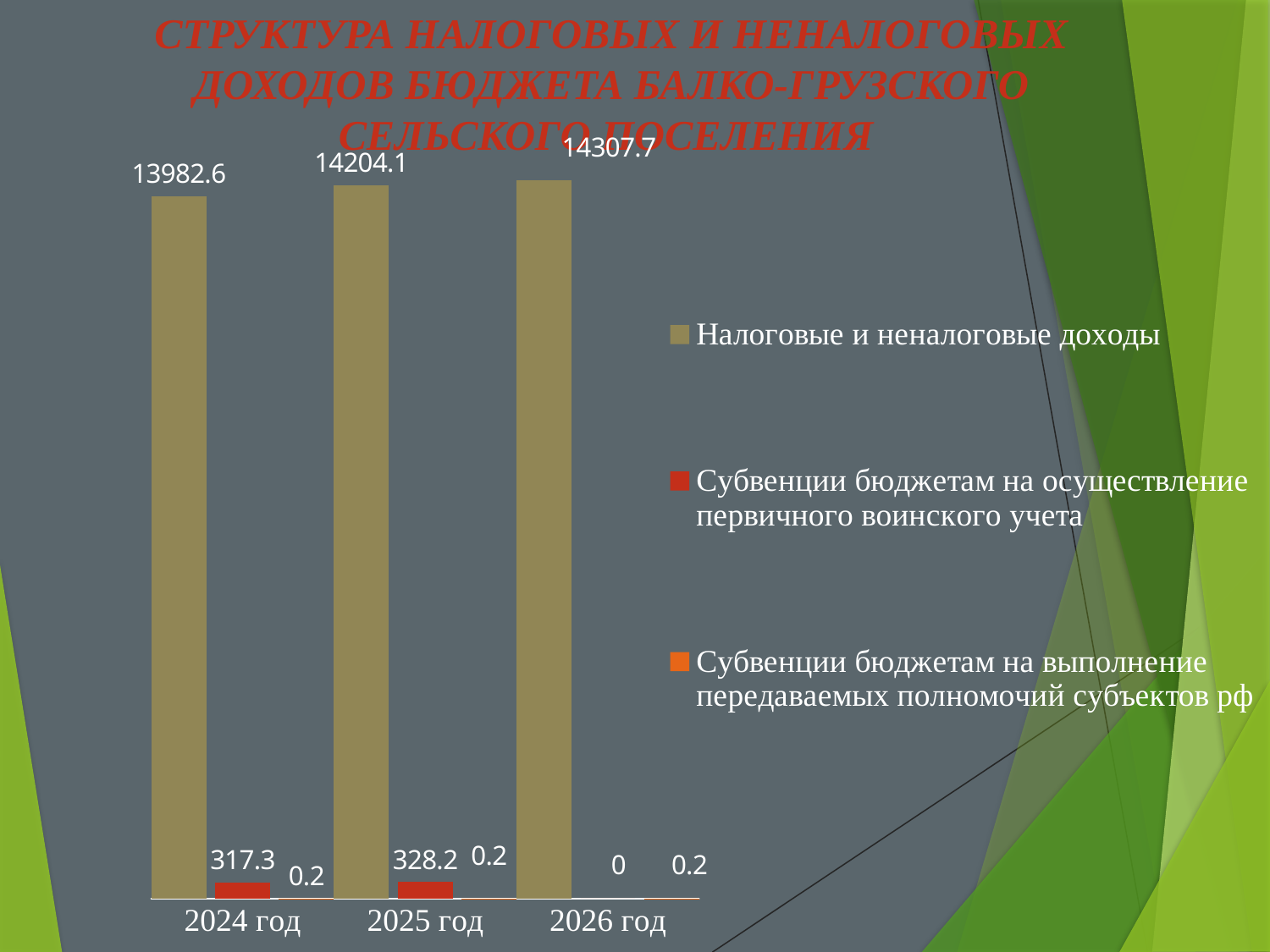
What is the value of Субвенции бюджетам на осуществление первичного воинского учета for 2025 год? 328.2 In which year is Налоговые и неналоговые доходы highest? 2026 год What is the value of Субвенции бюджетам на осуществление первичного воинского учета for 2026 год? 0 What kind of chart is shown on the slide? Bar chart Which is larger: Субвенции бюджетам на осуществление первичного воинского учета in 2024 год or in 2025 год? 2025 год What is the value of Налоговые и неналоговые доходы for 2024 год? 13982.6 How many years are shown on the x axis? 3 How many series does the legend list? 3 In which year is Налоговые и неналоговые доходы lowest? 2024 год What is the difference between Налоговые и неналоговые доходы in 2025 год and 2024 год? 221.5 What is the value of Налоговые и неналоговые доходы for 2026 год? 14307.7 What is the value of Субвенции бюджетам на выполнение передаваемых полномочий субъектов рф for 2024 год? 0.2